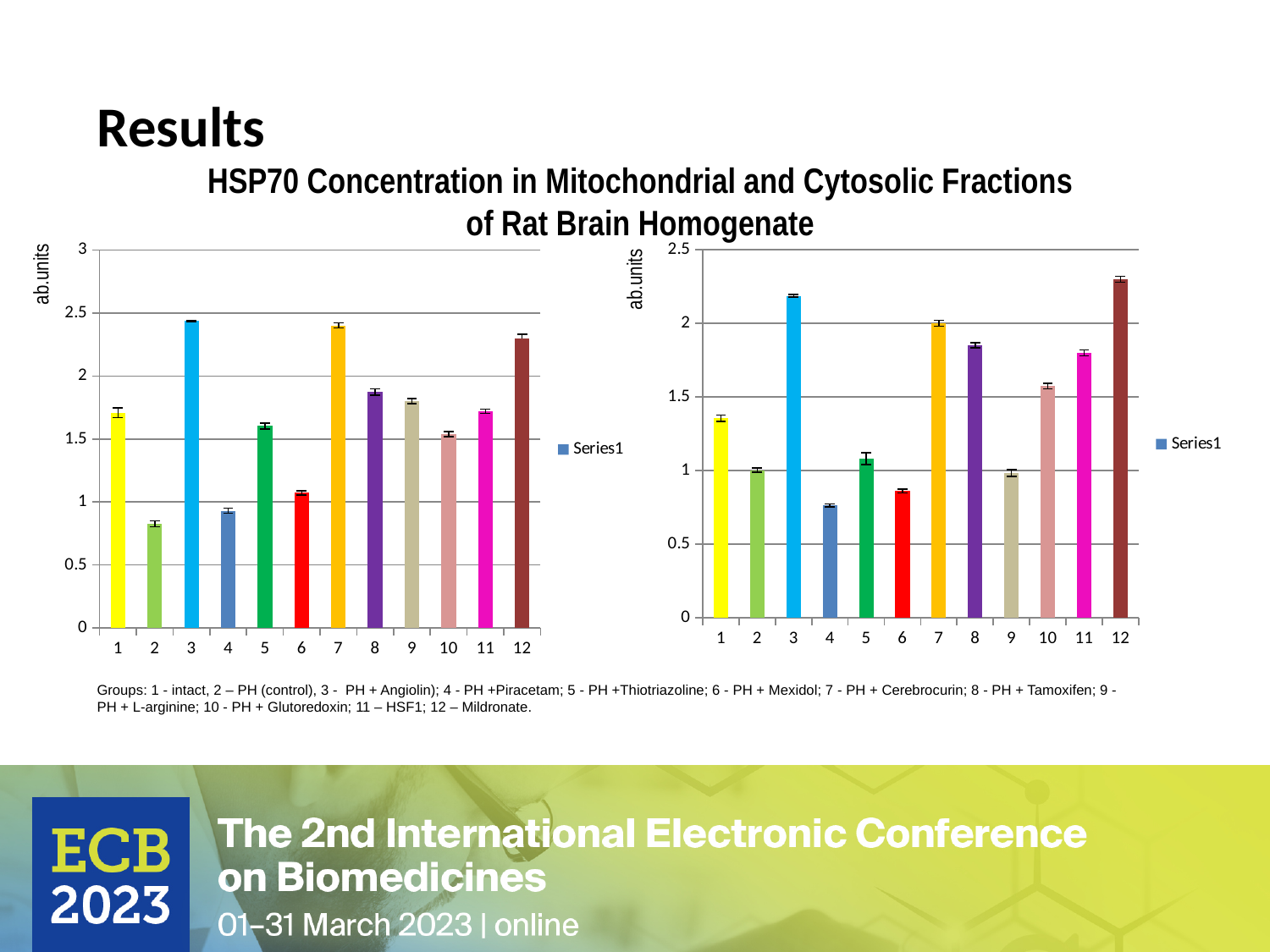
In the right chart, which is larger, the value for category 3 or the value for category 1? 3 In the left chart, is the value for category 3 greater or less than 2? greater In the left chart, which is larger, the value for category 8 or the value for category 6? 8 In the right chart, is the value for category 6 greater or less than 1? less In the right chart, which category has the lowest value? 4 How many series does the legend of the left chart list? 1 How many categories are shown on the x axis of the right chart? 12 In the right chart, is the value for category 7 greater or less than 1.5? greater What kind of chart is the left chart on the slide? bar chart In the right chart, which category has the highest value? 12 What is the label on the y axis of the left chart? ab.units